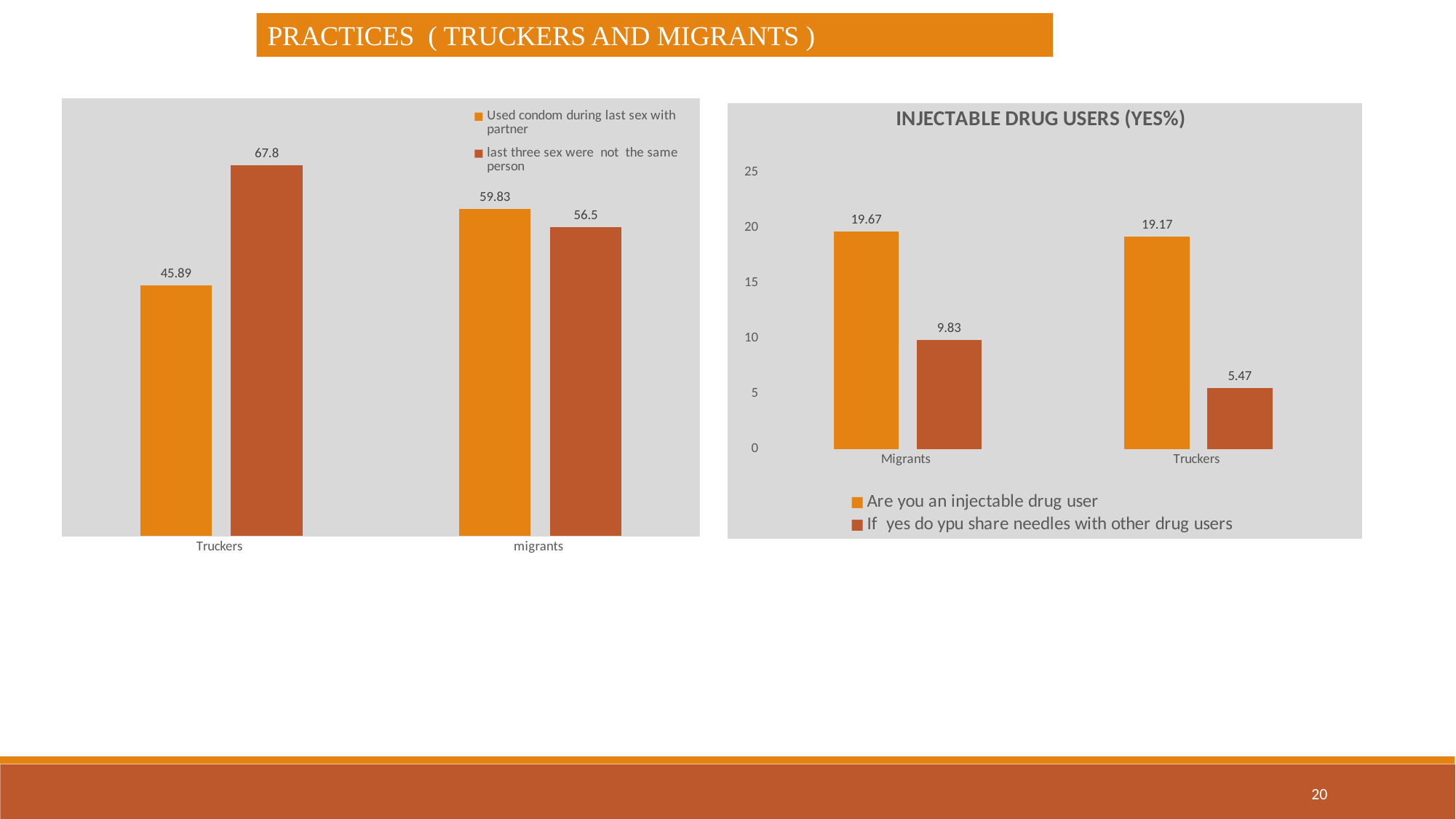
In the left chart, what is the difference between the two values for Truckers? 21.91 In the left chart, which category has the higher value for 'last three sex were not the same person'? Truckers In the left chart, how many series does the legend list? 2 In the 'INJECTABLE DRUG USERS (YES%)' chart, what is the difference between the Migrants and Truckers values for 'If yes do ypu share needles with other drug users'? 4.36 In the 'INJECTABLE DRUG USERS (YES%)' chart, what is the value for 'Are you an injectable drug user' for Migrants? 19.67 In the 'INJECTABLE DRUG USERS (YES%)' chart, which category has the lowest value for sharing needles? Truckers What is the title of the right-hand chart? INJECTABLE DRUG USERS (YES%) In the left chart, what kind of chart is shown? Bar chart In the 'INJECTABLE DRUG USERS (YES%)' chart, how many categories are shown on the x axis? 2 In the left chart, what is the value for 'last three sex were not the same person' for migrants? 56.5 In the 'INJECTABLE DRUG USERS (YES%)' chart, what is the value for 'If yes do ypu share needles with other drug users' for Truckers? 5.47 In the left chart, what is the value for 'Used condom during last sex with partner' for Truckers? 45.89